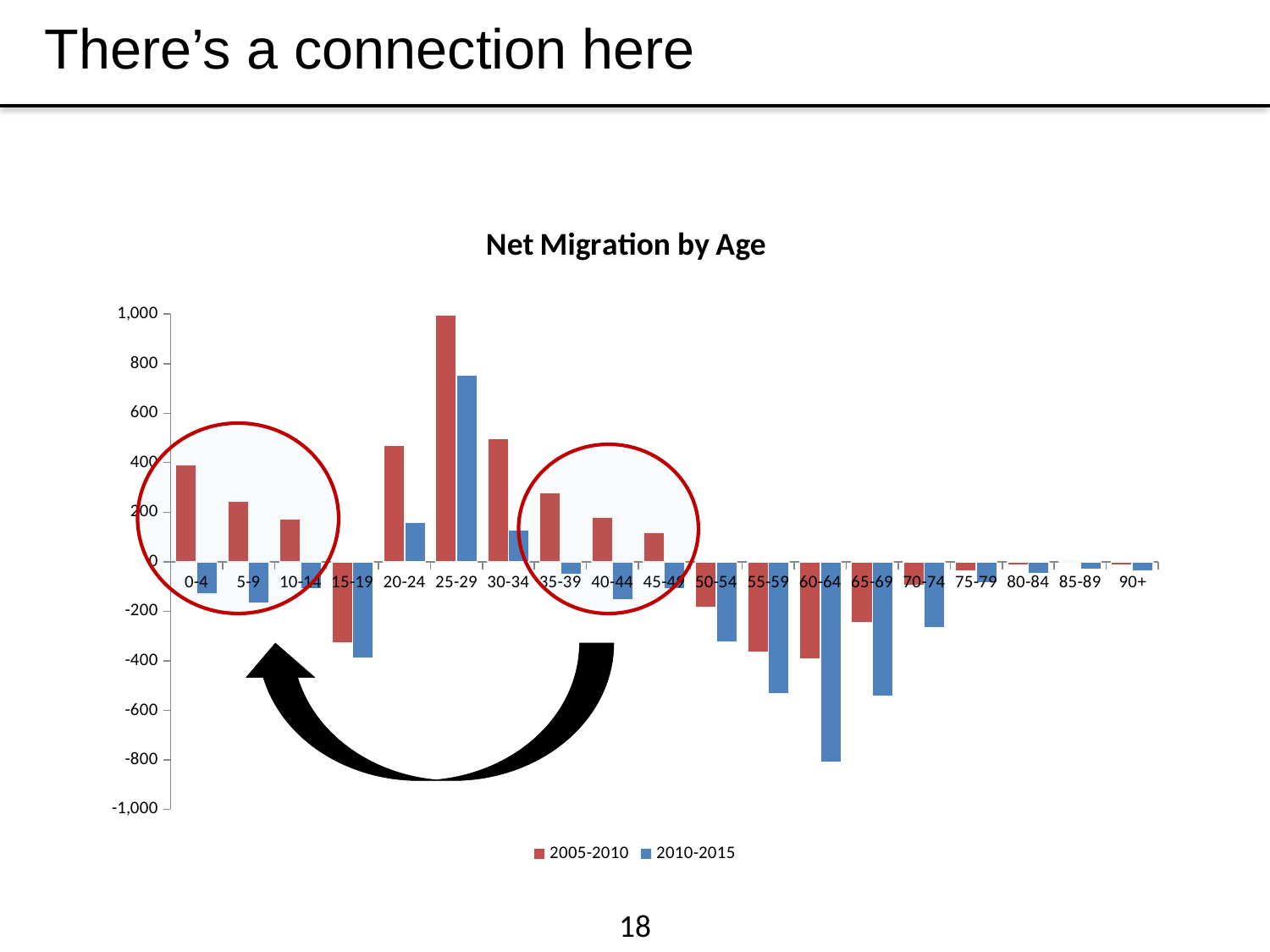
Is the 2005-2010 value for the 0-4 age group greater or less than 200? greater For the 25-29 age group, which series has the larger value, 2005-2010 or 2010-2015? 2005-2010 Is the 2010-2015 value for the 60-64 age group greater or less than -600? less How many series does the legend list? 2 Is the 2005-2010 value for the 25-29 age group greater or less than 800? greater Which colour represents the 2010-2015 series in the legend? blue Which age group has the lowest value for the 2010-2015 series? 60-64 Which age group has the highest value for the 2005-2010 series? 25-29 What kind of chart is shown on the slide? bar chart Which age group has the highest value for the 2010-2015 series? 25-29 What is the title of the chart? Net Migration by Age How many age categories are shown on the x axis? 19